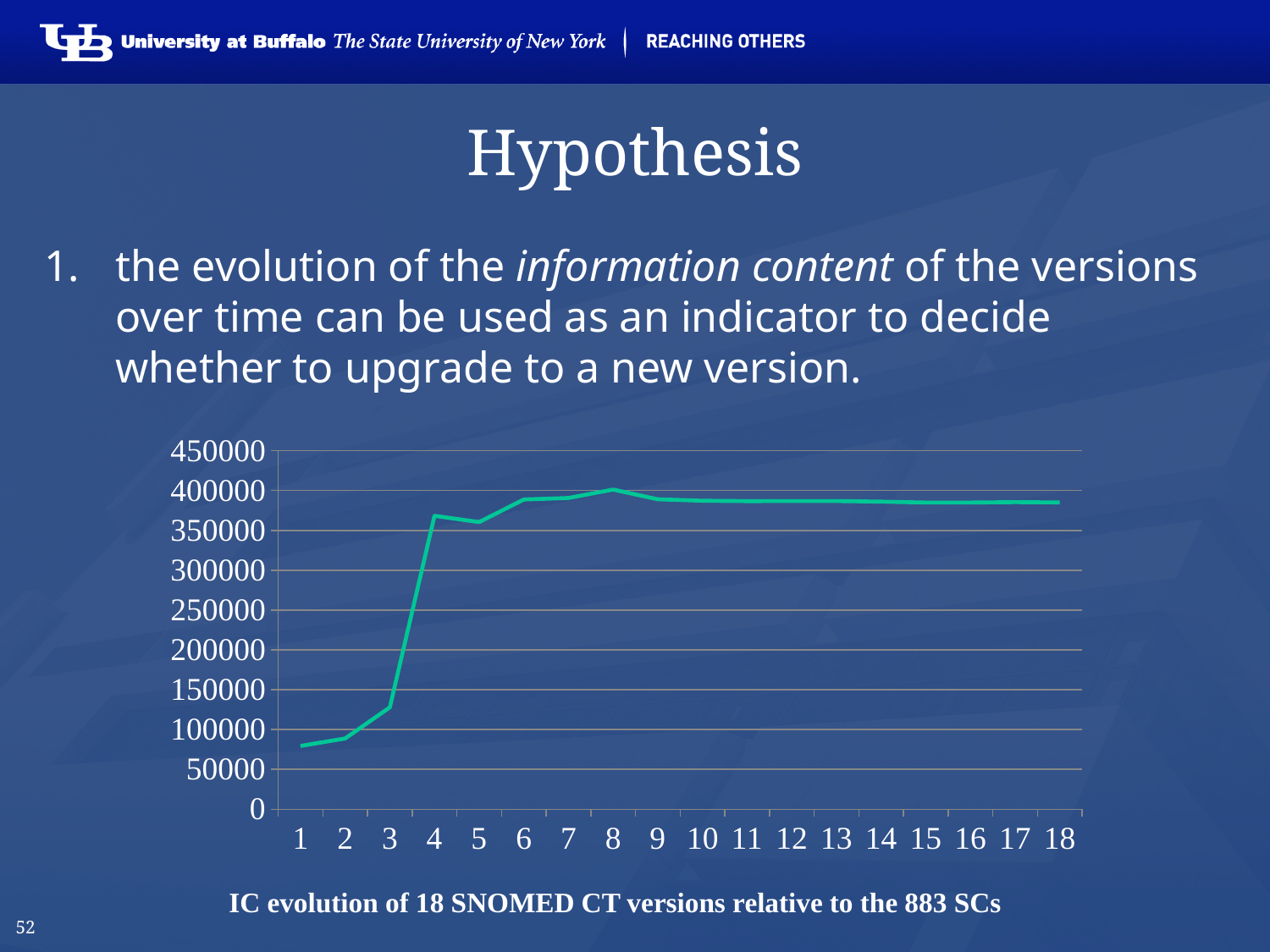
Is the value for version 2 greater or less than 150000? less How many points (versions) are plotted along the x axis? 18 Which version number has the lowest value on the chart? 1 Do the values generally rise or fall from version 1 to version 18? rise What is the caption printed below the chart? IC evolution of 18 SNOMED CT versions relative to the 883 SCs What kind of chart is shown on the slide? line chart Is the value for version 4 greater or less than 300000? greater Which has the larger value, version 3 or version 4? version 4 Is the value for version 18 greater or less than 350000? greater Which version number has the highest value on the chart? 8